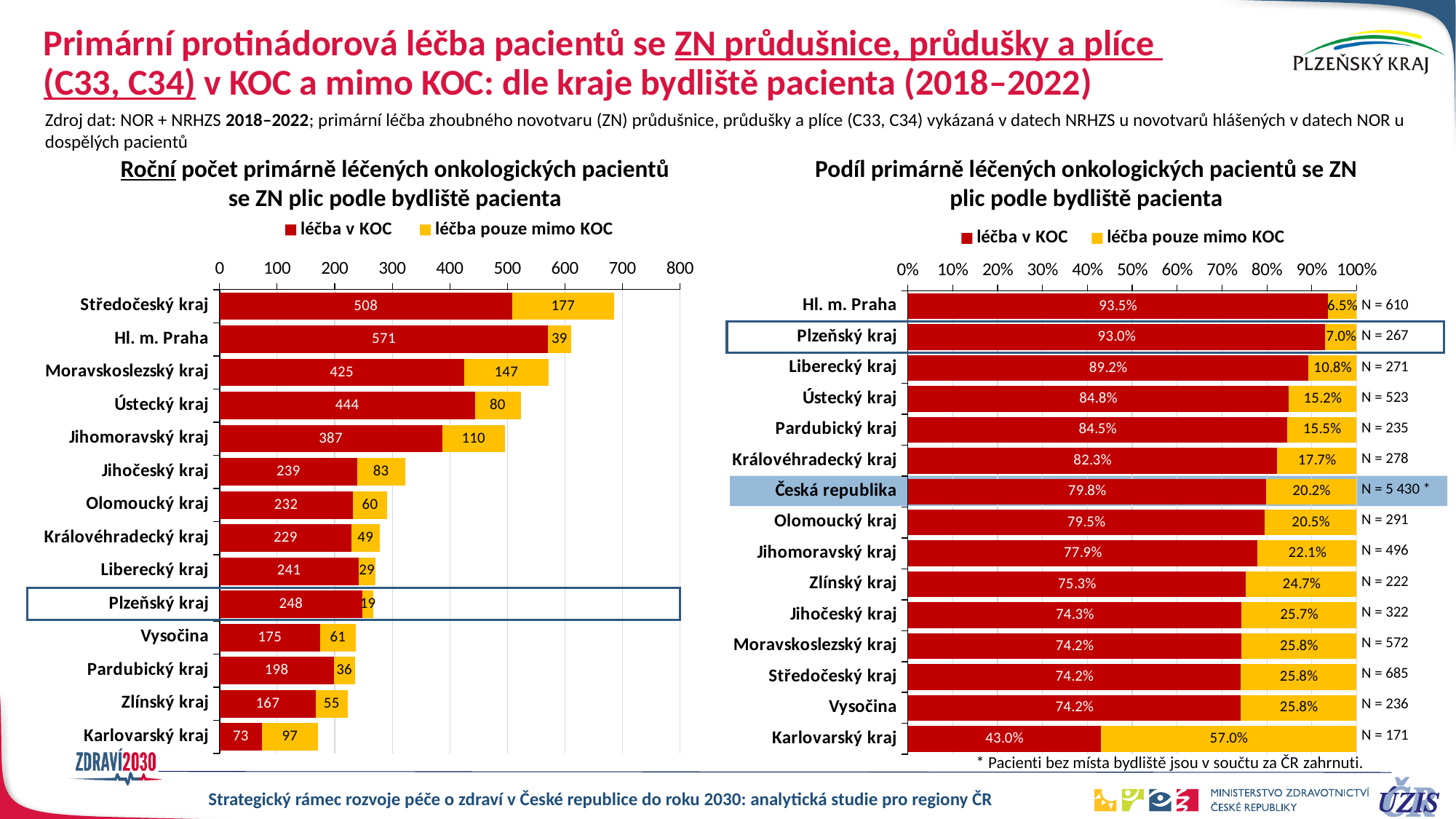
In the right chart (Podíl primárně léčených onkologických pacientů), is the 'léčba v KOC' share for Česká republika larger or smaller than for Olomoucký kraj? larger In the left chart (Roční počet primárně léčených onkologických pacientů), what is the difference between 'léčba v KOC' for Ústecký kraj and Moravskoslezský kraj? 19 In the left chart (Roční počet primárně léčených onkologických pacientů), how many regions are shown? 14 In the left chart (Roční počet primárně léčených onkologických pacientů), what is the total of the stacked bar for Hl. m. Praha? 610 How many series does the legend of the right chart (Podíl primárně léčených onkologických pacientů) list? 2 In the right chart (Podíl primárně léčených onkologických pacientů), which region has the lowest 'léčba v KOC' share? Karlovarský kraj In the left chart (Roční počet primárně léčených onkologických pacientů), which region has the lowest 'léčba v KOC' value? Karlovarský kraj In the left chart (Roční počet primárně léčených onkologických pacientů), which region has the highest 'léčba v KOC' value? Hl. m. Praha In the left chart (Roční počet primárně léčených onkologických pacientů), what is the value of 'léčba v KOC' for Plzeňský kraj? 248 In the left chart (Roční počet primárně léčených onkologických pacientů), what is the value of 'léčba pouze mimo KOC' for Středočeský kraj? 177 In the right chart (Podíl primárně léčených onkologických pacientů), what is the 'léčba v KOC' share for Plzeňský kraj? 93.0% In the right chart (Podíl primárně léčených onkologických pacientů), what is the 'léčba pouze mimo KOC' share for Karlovarský kraj? 57.0%